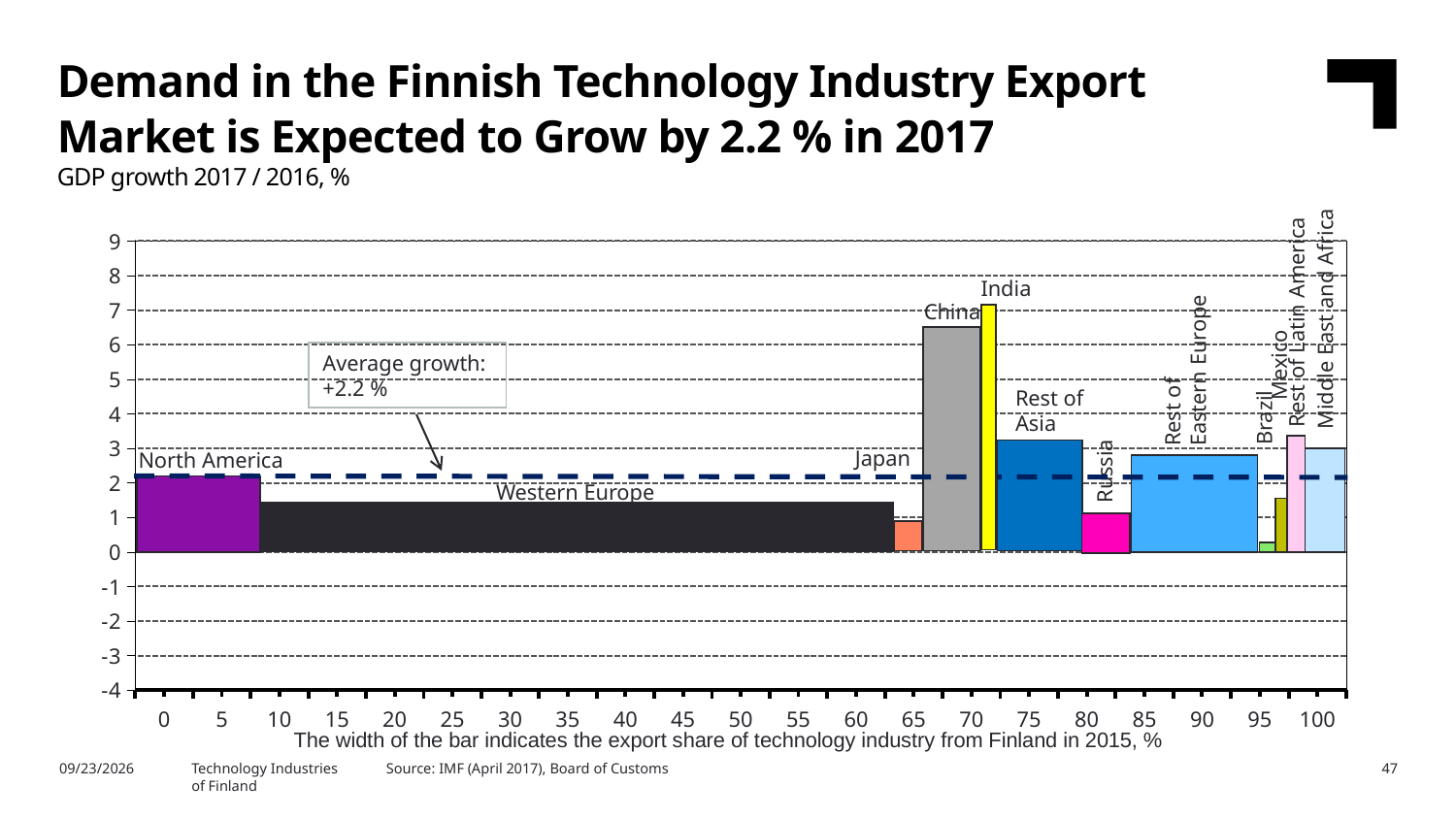
Is the value for China greater or less than 5? greater Is the value for Rest of Asia greater or less than 2? greater What kind of chart is shown on the slide? bar chart According to the note below the x axis, what does the width of each bar indicate? The export share of technology industry from Finland in 2015 Which region has the highest GDP growth in the chart? India Which region has the lowest GDP growth in the chart? Brazil What average growth value is printed in the annotation box on the chart? +2.2 % Which is larger, the value for China or the value for Rest of Asia? China Is the value for Western Europe greater or less than 2? less Which is larger, the value for North America or the value for Western Europe? North America